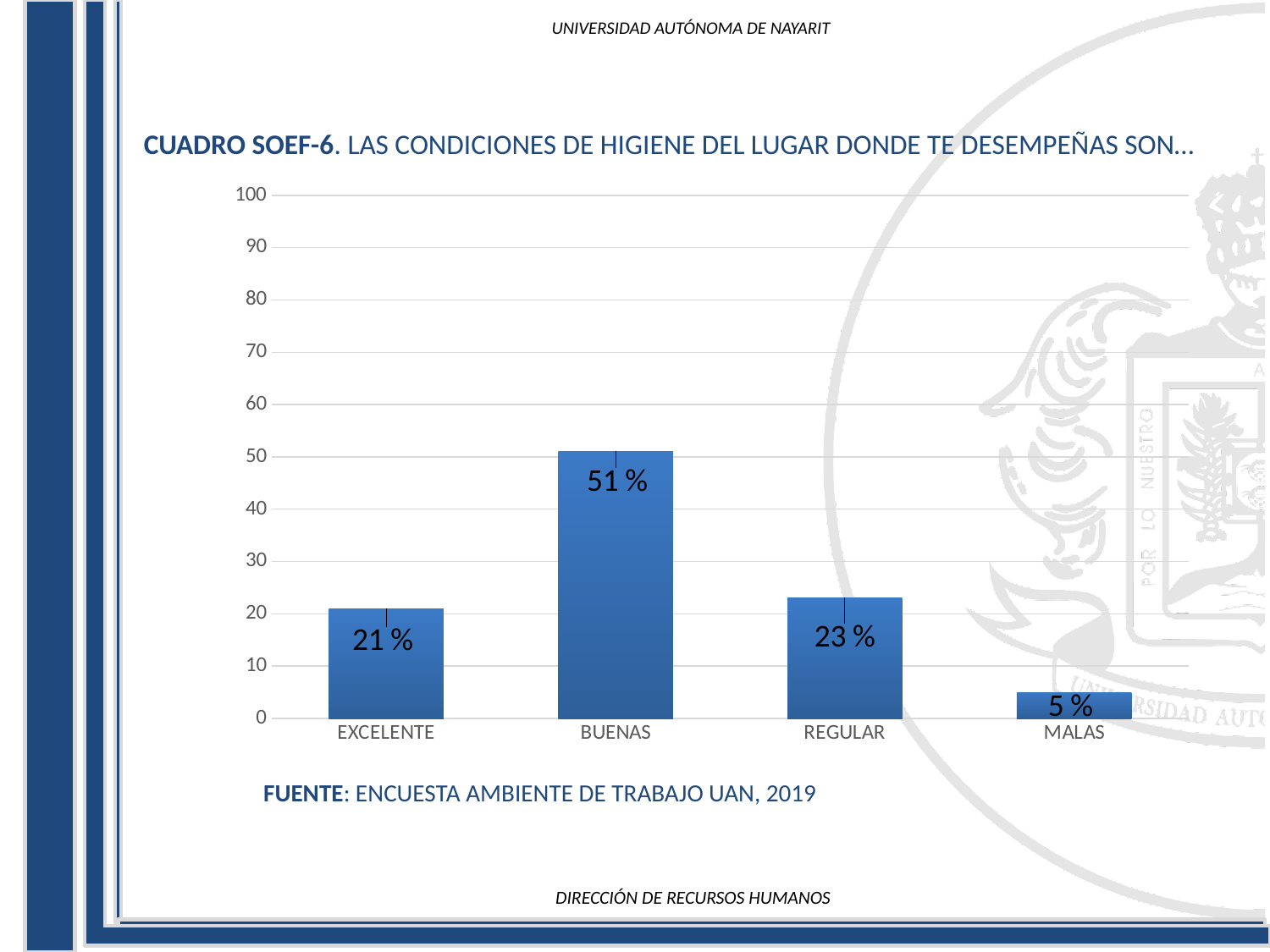
What kind of chart is shown on the slide? bar chart Which is larger, the value for REGULAR or the value for EXCELENTE? REGULAR What is the value for BUENAS? 51 % Which category has the lowest value? MALAS What is the difference between the values for BUENAS and REGULAR? 28 % How many categories are shown on the x axis? 4 What is the value for REGULAR? 23 % What is the difference between the values for EXCELENTE and MALAS? 16 % What is the value for MALAS? 5 % What is the value for EXCELENTE? 21 % Which category has the highest value? BUENAS Is the value for BUENAS greater or less than 40? greater